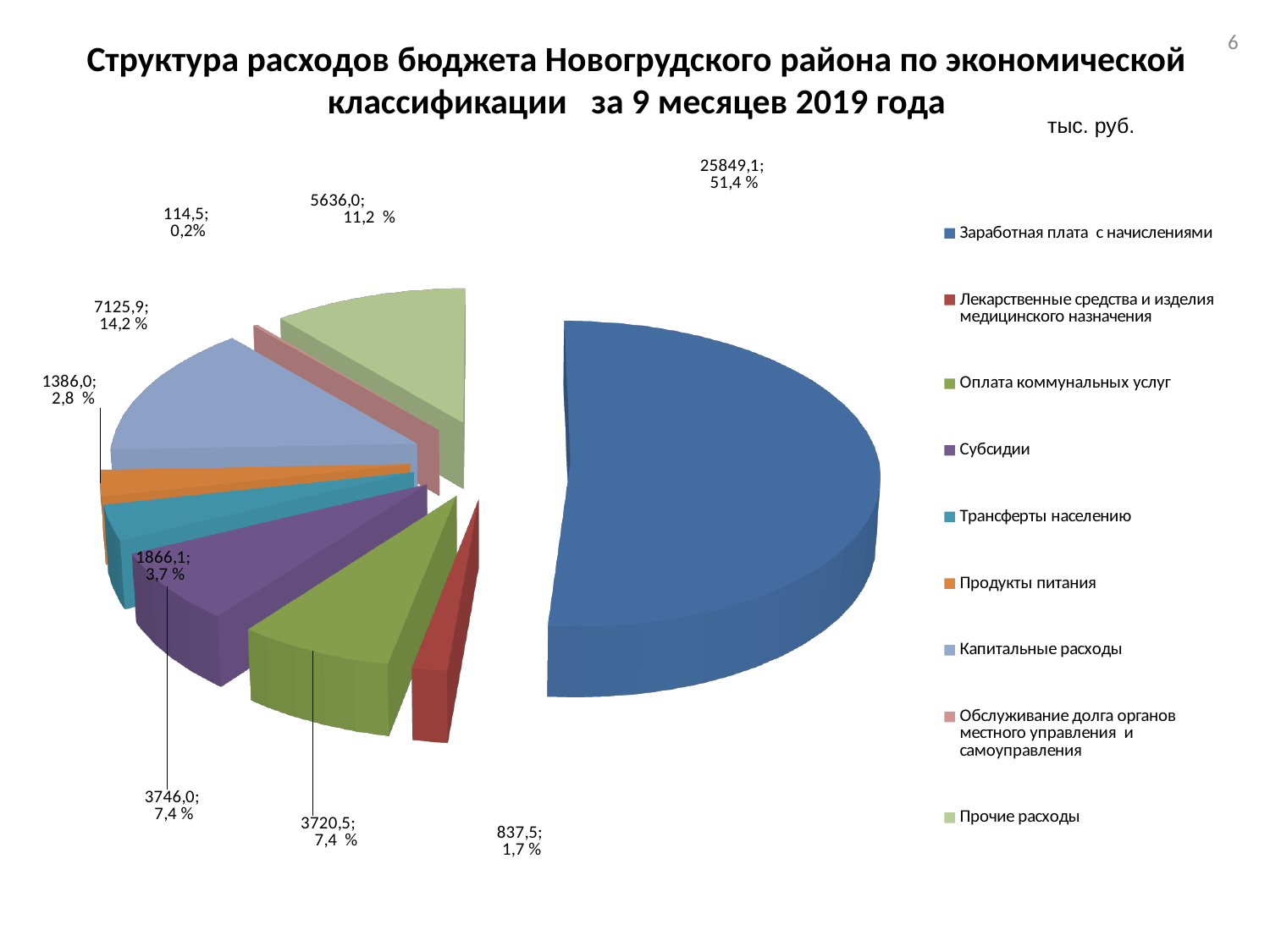
What is the value for Капитальные расходы? 7125,9 Which is larger, Капитальные расходы or Прочие расходы? Капитальные расходы How many categories does the legend of the pie chart list? 9 What share of the pie does Прочие расходы take? 11,2 % What is the difference between the values for Капитальные расходы and Прочие расходы? 1489,9 What is the value for Трансферты населению? 1866,1 What kind of chart is shown on the slide? pie chart What share of the pie does Заработная плата с начислениями take? 51,4 % What is the value for Заработная плата с начислениями? 25849,1 Which category has the largest slice of the pie? Заработная плата с начислениями Which category has the smallest slice of the pie? Обслуживание долга органов местного управления и самоуправления In what units are the values on the chart given? тыс. руб.